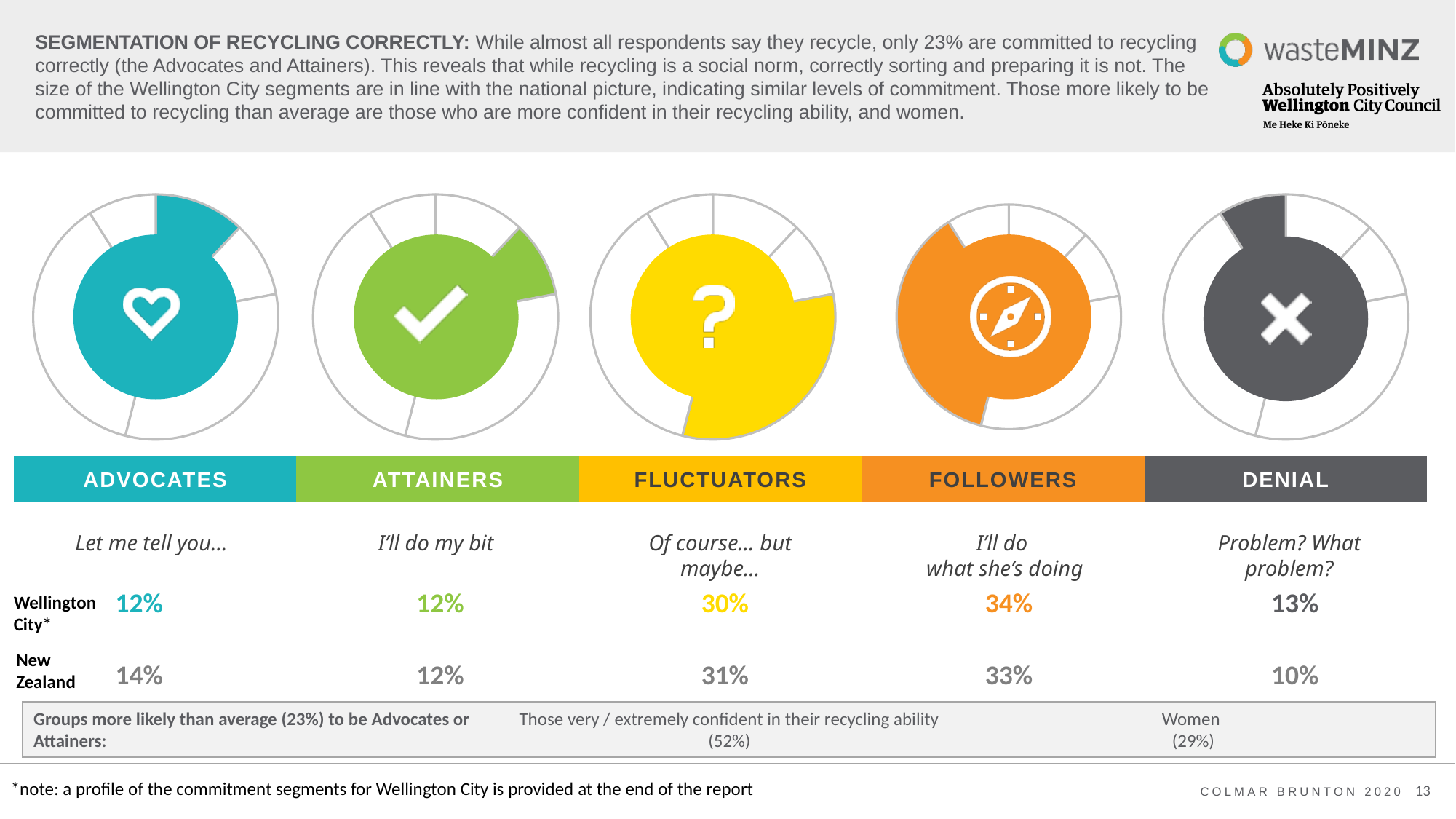
What icon appears inside the Advocates circle? A heart Is the Denial share larger for Wellington City or for New Zealand? Wellington City What colour is used for the Followers segment? Orange What percentage of New Zealand respondents fall into the Denial segment? 10% How many percentage points higher is the Wellington City Followers share than the Wellington City Advocates share? 22 percentage points How many recycling commitment segments are shown on the slide? 5 What is the difference between the New Zealand and Wellington City percentages for Fluctuators? 1% What is the Wellington City percentage for Attainers? 12% Which segment has the smallest share of New Zealand respondents? Denial What percentage of Wellington City respondents are Fluctuators? 30% Which segment has the largest share of Wellington City respondents? Followers What is the New Zealand percentage for Advocates? 14%